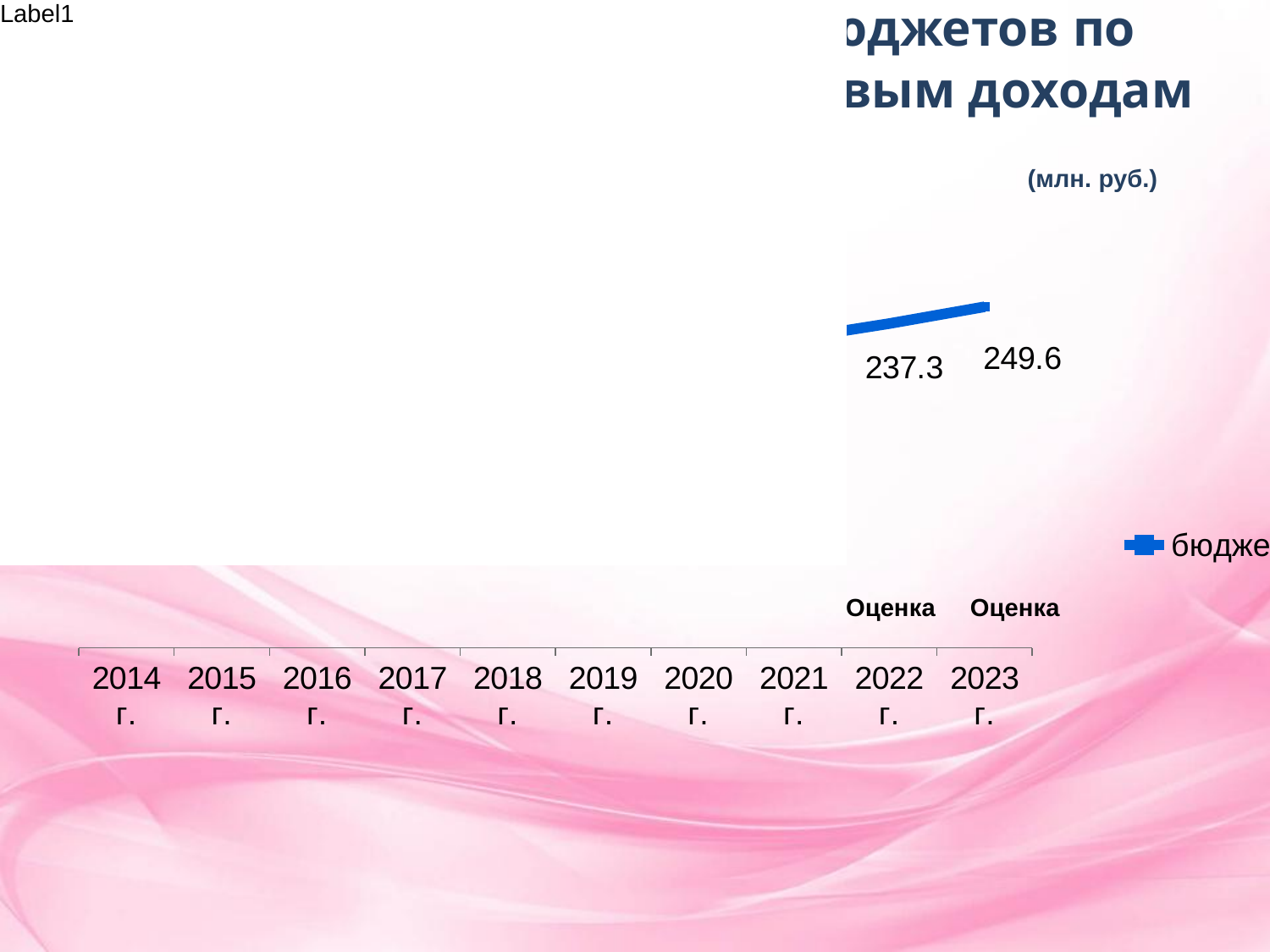
What is the first year shown on the x axis? 2014 г. What is the value for 2023 г.? 249.6 Which is larger, the value for 2022 г. or the value for 2023 г.? 2023 г. How many years are shown on the x axis? 10 What kind of chart is this? line chart What is the value for 2022 г.? 237.3 What is the difference between the values for 2023 г. and 2022 г.? 12.3 Does the value rise or fall from 2022 г. to 2023 г.? rise What unit is stated for the chart values? млн. руб.